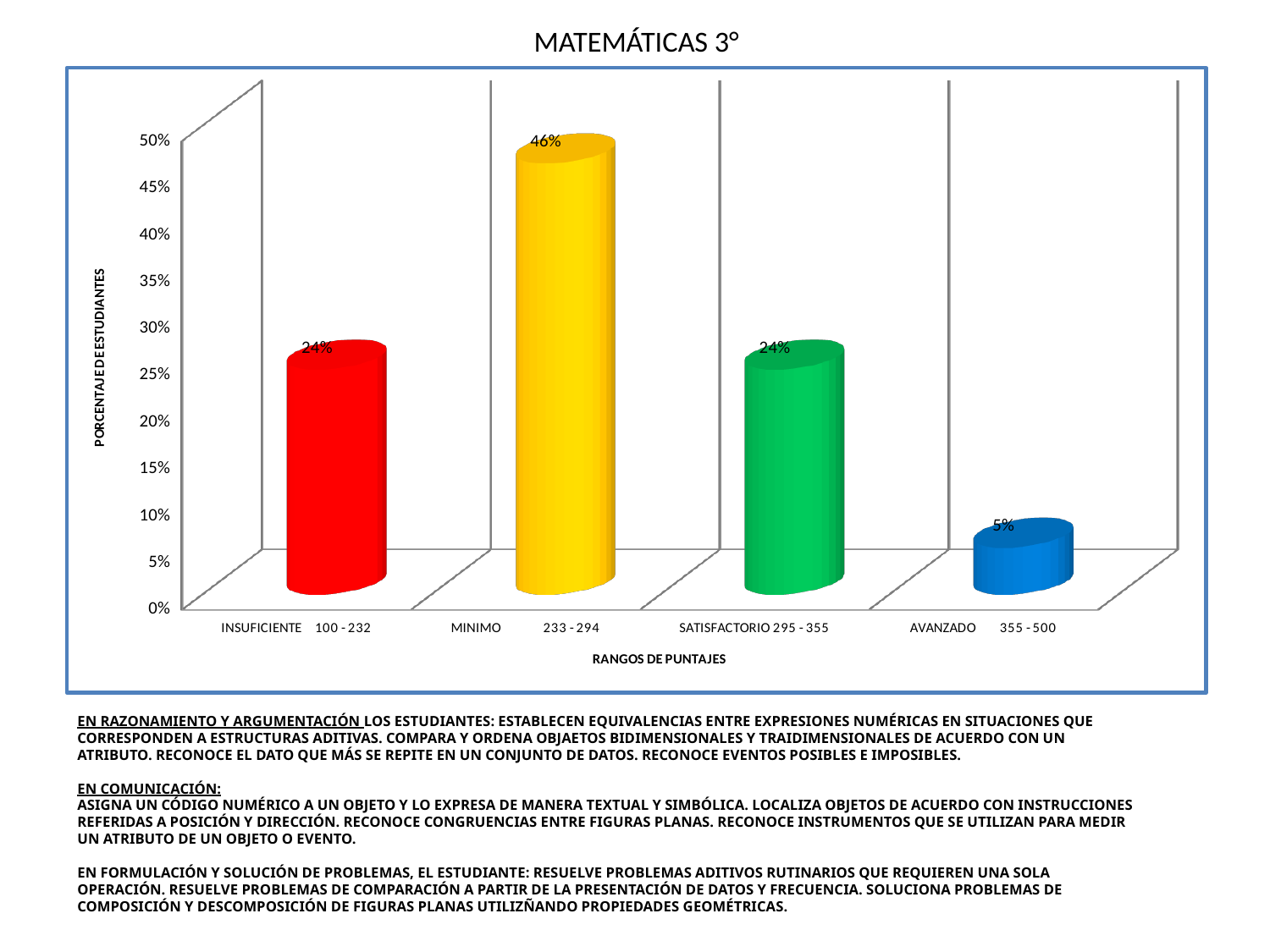
What is the difference in percentage points between the MINIMO and SATISFACTORIO categories? 22 What percentage of students is shown for the MINIMO (233 - 294) category? 46% Which is larger, the value for SATISFACTORIO (295 - 355) or the value for AVANZADO (355 - 500)? SATISFACTORIO 295 - 355 What kind of chart is shown on the slide? Bar chart Which score range category has the lowest percentage of students? AVANZADO 355 - 500 Is the value for MINIMO (233 - 294) greater or less than 40%? greater What percentage of students is shown for the INSUFICIENTE (100 - 232) category? 24% What is the title of the chart? MATEMÁTICAS 3° How many score range categories are shown on the chart? 4 What is the difference in percentage points between the MINIMO and AVANZADO categories? 41 Which score range category has the highest percentage of students? MINIMO 233 - 294 What percentage of students is shown for the AVANZADO (355 - 500) category? 5%